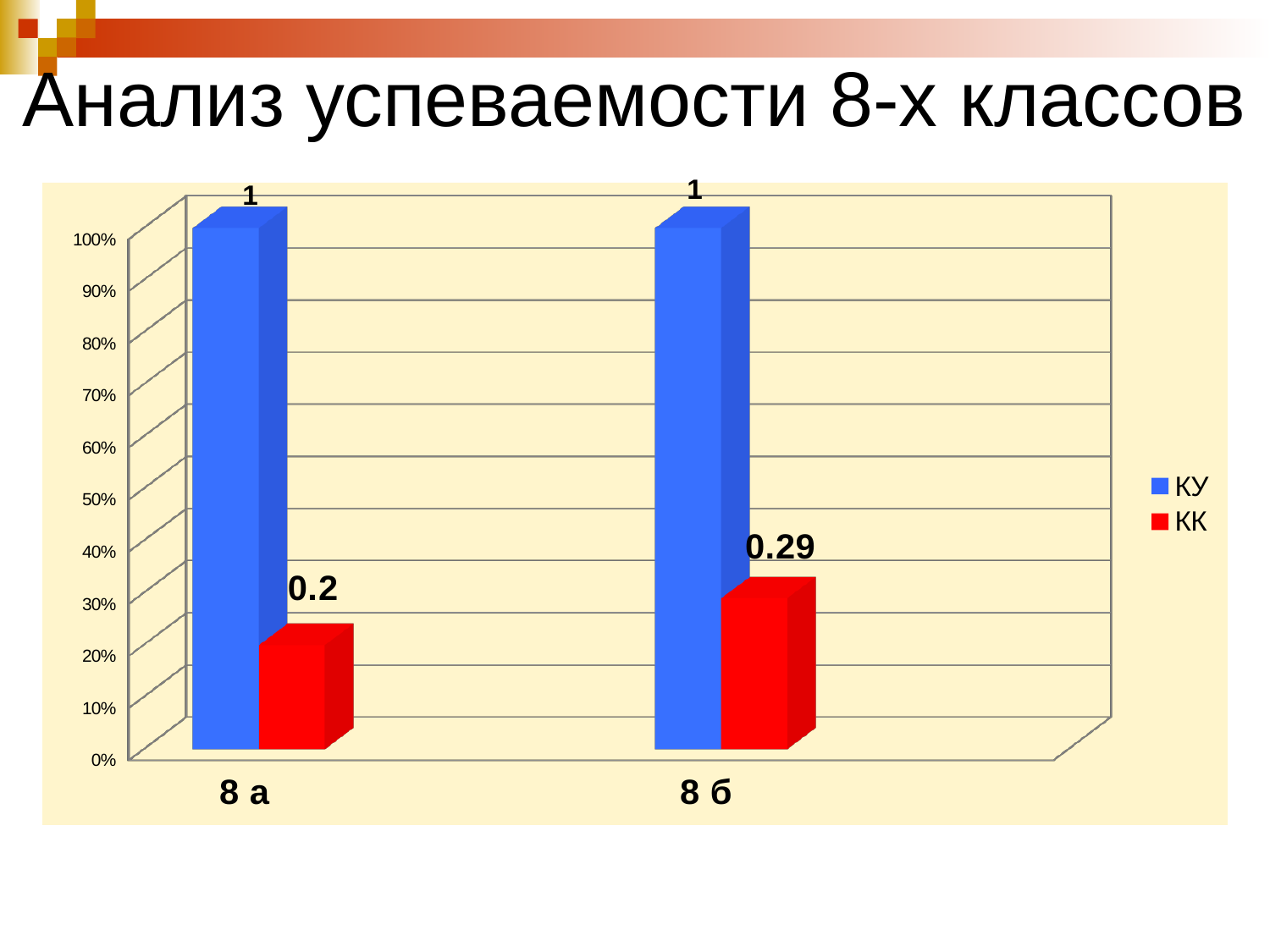
Is the КК value for 8 а larger or smaller than the КУ value for 8 а? smaller What is the value of КК for 8 а? 0.2 Which class has the higher КК value? 8 б Which colour represents the КК series? red Is the КК value for 8 б greater or less than 40%? less What is the difference between the КК values for 8 б and 8 а? 0.09 What is the title of the slide? Анализ успеваемости 8-х классов What is the value of КУ for 8 а? 1 What kind of chart is shown on the slide? bar chart What is the value of КК for 8 б? 0.29 How many classes are shown on the x axis? 2 How many series does the legend list? 2